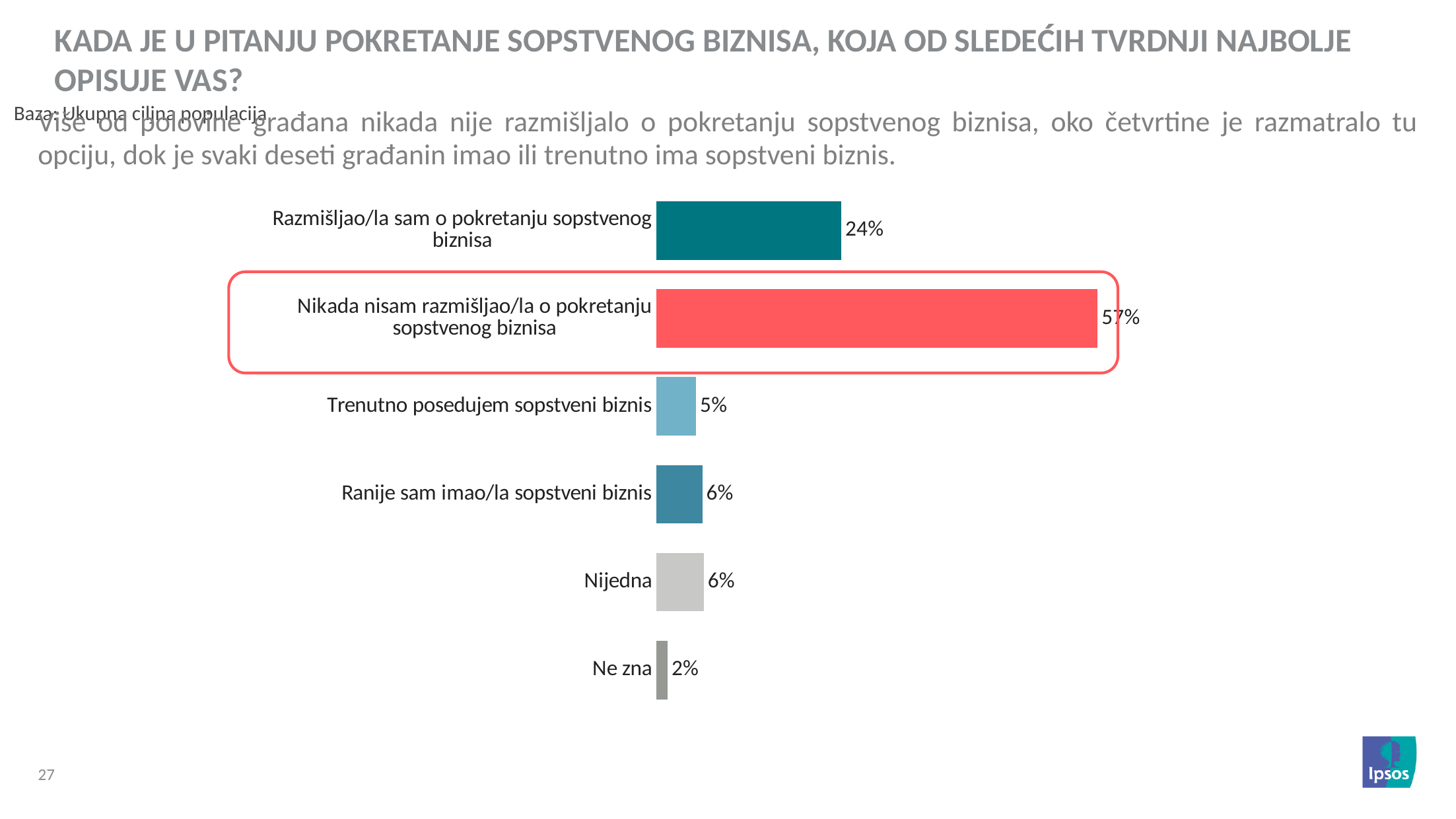
Which category has the highest value? Nikada nisam razmišljao/la o pokretanju sopstvenog biznisa Which bar is highlighted with a red outline? Nikada nisam razmišljao/la o pokretanju sopstvenog biznisa What is the difference between the values for "Nijedna" and "Ne zna"? 4% What is the value for "Ne zna"? 2% What kind of chart is shown on the slide? Bar chart What is the value for "Razmišljao/la sam o pokretanju sopstvenog biznisa"? 24% What is the difference between the values for "Nikada nisam razmišljao/la o pokretanju sopstvenog biznisa" and "Razmišljao/la sam o pokretanju sopstvenog biznisa"? 33% Which category has the lowest value? Ne zna What is the value for "Nikada nisam razmišljao/la o pokretanju sopstvenog biznisa"? 57% How many categories are shown in the chart? 6 What is the value for "Trenutno posedujem sopstveni biznis"? 5% Which is larger: the value for "Ranije sam imao/la sopstveni biznis" or "Trenutno posedujem sopstveni biznis"? Ranije sam imao/la sopstveni biznis